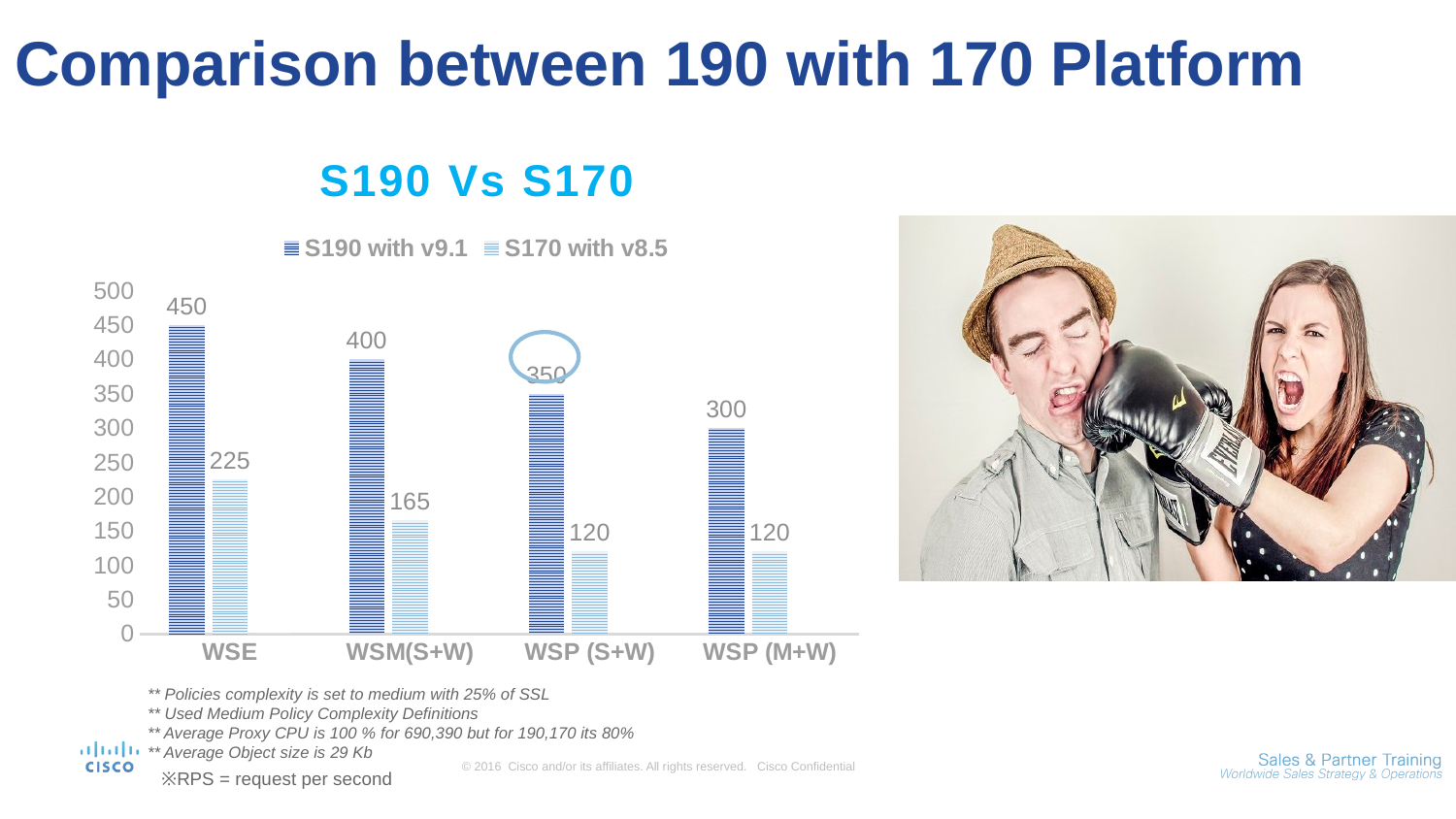
What is the difference between S190 with v9.1 and S170 with v8.5 in the WSE category? 225 How many categories are shown on the x axis? 4 What is the value for S170 with v8.5 in the WSM(S+W) category? 165 What is the value for S190 with v9.1 in the WSE category? 450 What kind of chart is shown on the slide? Bar chart Which category has the lowest value for S190 with v9.1? WSP (M+W) Which category has the highest value for S190 with v9.1? WSE What is the value for S190 with v9.1 in the WSP (M+W) category? 300 How many series does the legend list? 2 What is the difference between S190 with v9.1 and S170 with v8.5 in the WSP (S+W) category? 230 What is the title of the chart? S190 Vs S170 Which is larger in the WSM(S+W) category: S190 with v9.1 or S170 with v8.5? S190 with v9.1